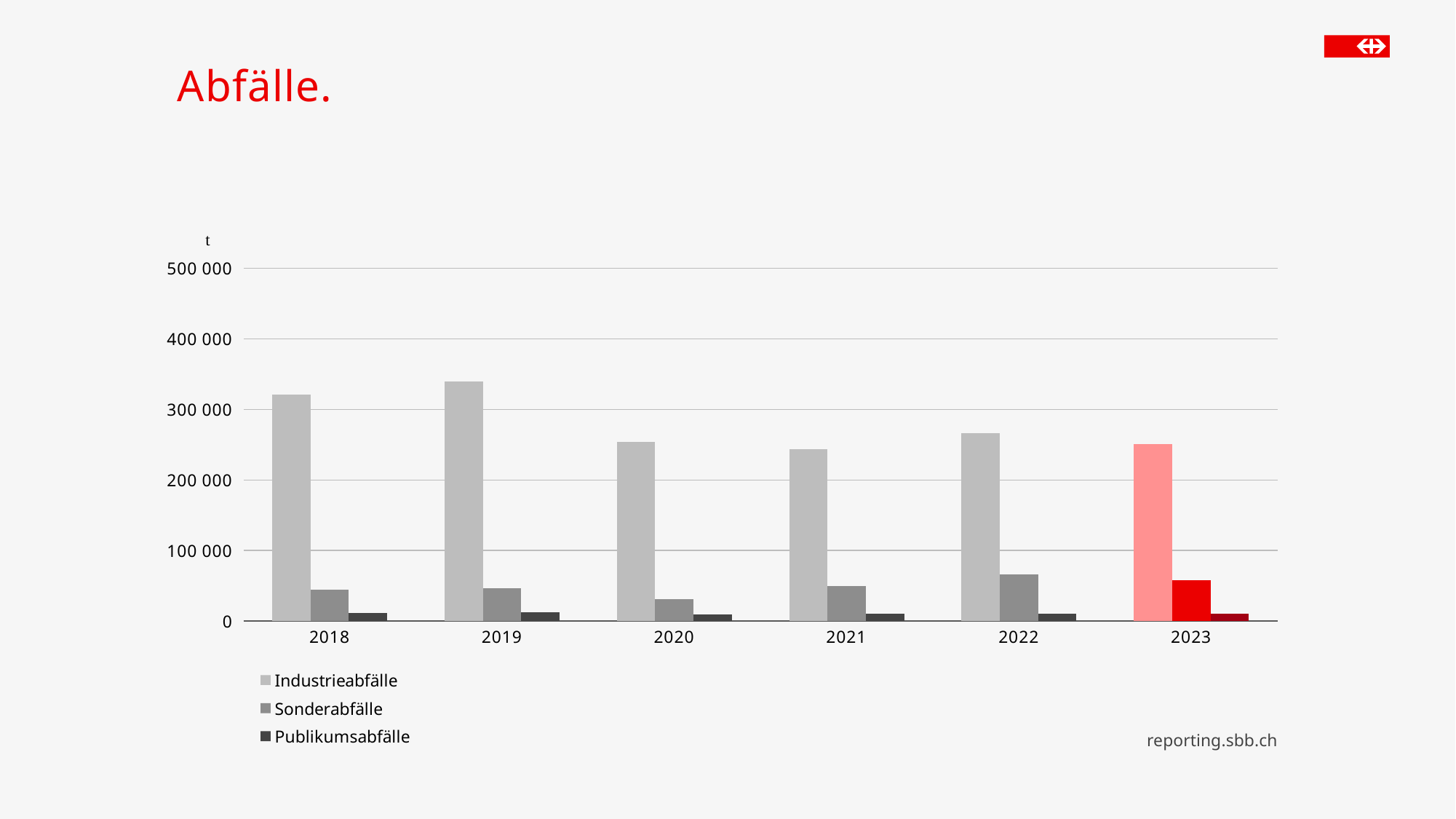
In which year is the Sonderabfälle value highest? 2022 Is the Industrieabfälle value for 2019 greater or less than 300 000? greater In which year is the Industrieabfälle value highest? 2019 Does the Industrieabfälle value rise or fall from 2019 to 2021? fall In which year is the Sonderabfälle value lowest? 2020 What kind of chart is shown on the slide? bar chart Is the Sonderabfälle value for 2022 greater or less than 100 000? less How many years are shown on the x axis? 6 Which year has the larger Industrieabfälle value, 2018 or 2019? 2019 Is the Industrieabfälle value for 2020 greater or less than 300 000? less What unit is shown on the y axis of the chart? t How many series does the legend list? 3